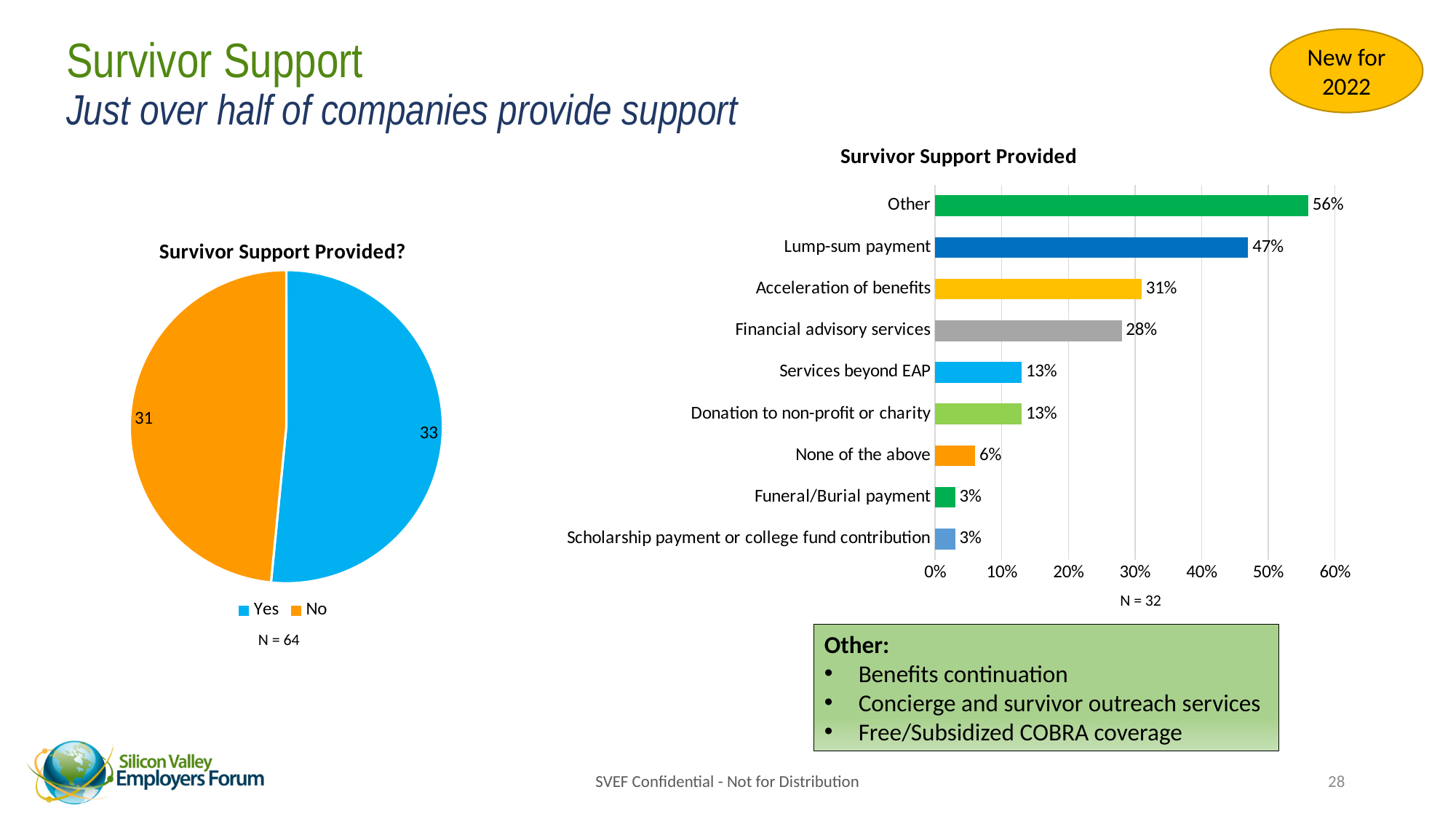
In the 'Survivor Support Provided?' pie chart, how many slices are there? 2 In the 'Survivor Support Provided?' pie chart, what is the value for Yes? 33 In the 'Survivor Support Provided' bar chart, which category has the highest value? Other In the 'Survivor Support Provided' bar chart, what is the value for Lump-sum payment? 47% What kind of chart is the 'Survivor Support Provided' chart on the right? Bar chart In the 'Survivor Support Provided' bar chart, what is the value for Financial advisory services? 28% In the 'Survivor Support Provided' bar chart, which is larger: Acceleration of benefits or Financial advisory services? Acceleration of benefits In the 'Survivor Support Provided' bar chart, how many categories are shown? 9 In the 'Survivor Support Provided' bar chart, what is the difference between Other and Lump-sum payment? 9% In the 'Survivor Support Provided' bar chart, what is the value for None of the above? 6% In the 'Survivor Support Provided?' pie chart, what is the value for No? 31 In the 'Survivor Support Provided?' pie chart, what is the difference between the Yes and No values? 2